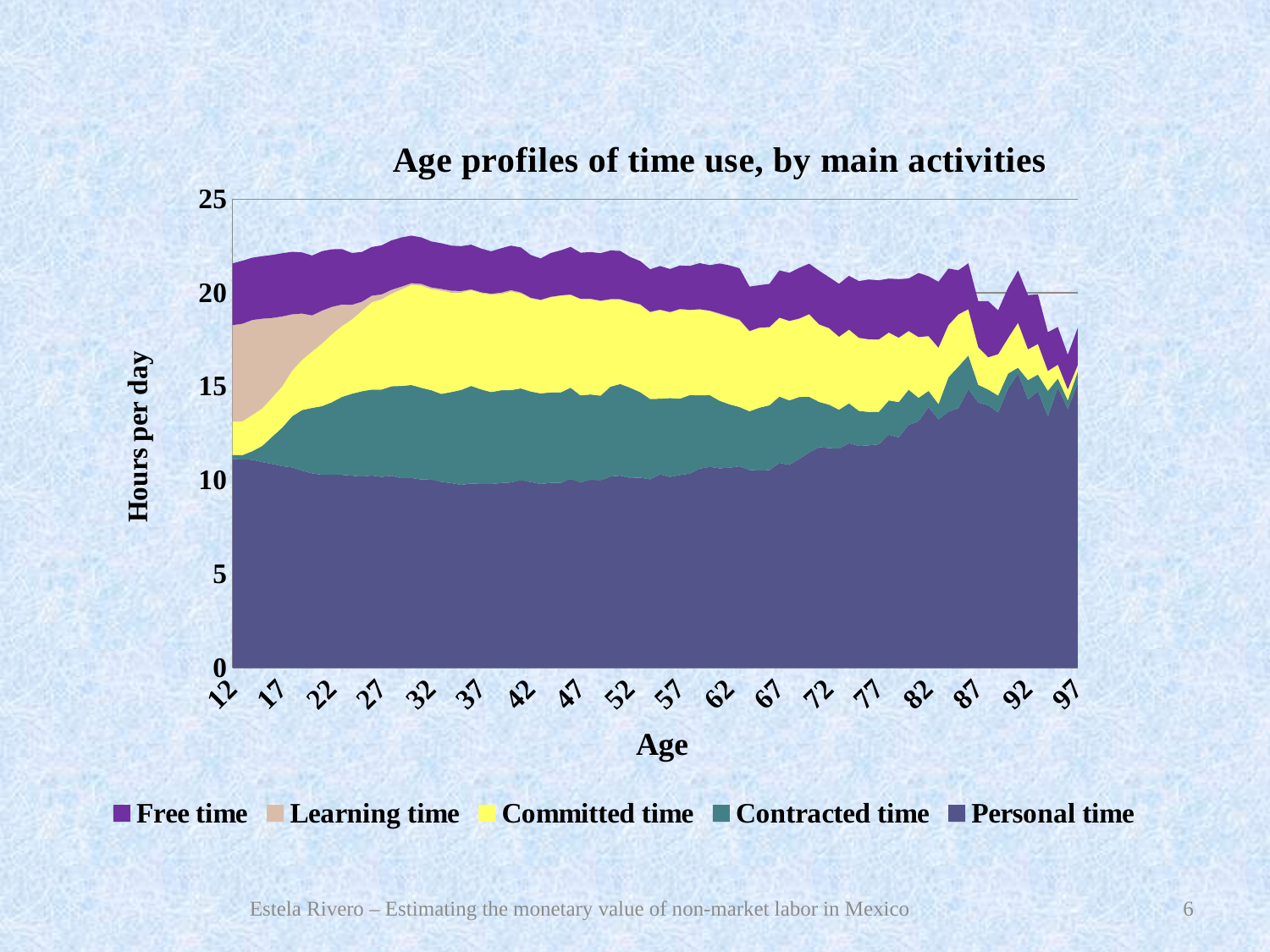
What is the label of the vertical axis? Hours per day How many age tick labels are shown on the x axis? 18 Which series is plotted at the bottom of the stack? Personal time Is the value for Personal time at age 12 greater or less than 10? greater Is the value for Personal time at age 97 greater or less than 10? greater What is the title of the chart? Age profiles of time use, by main activities Is the total of all activities at age 97 greater or less than 20? less What kind of chart is shown on the slide? Stacked area chart Does the Personal time area rise or fall between age 62 and age 82? rise How many series does the legend list? 5